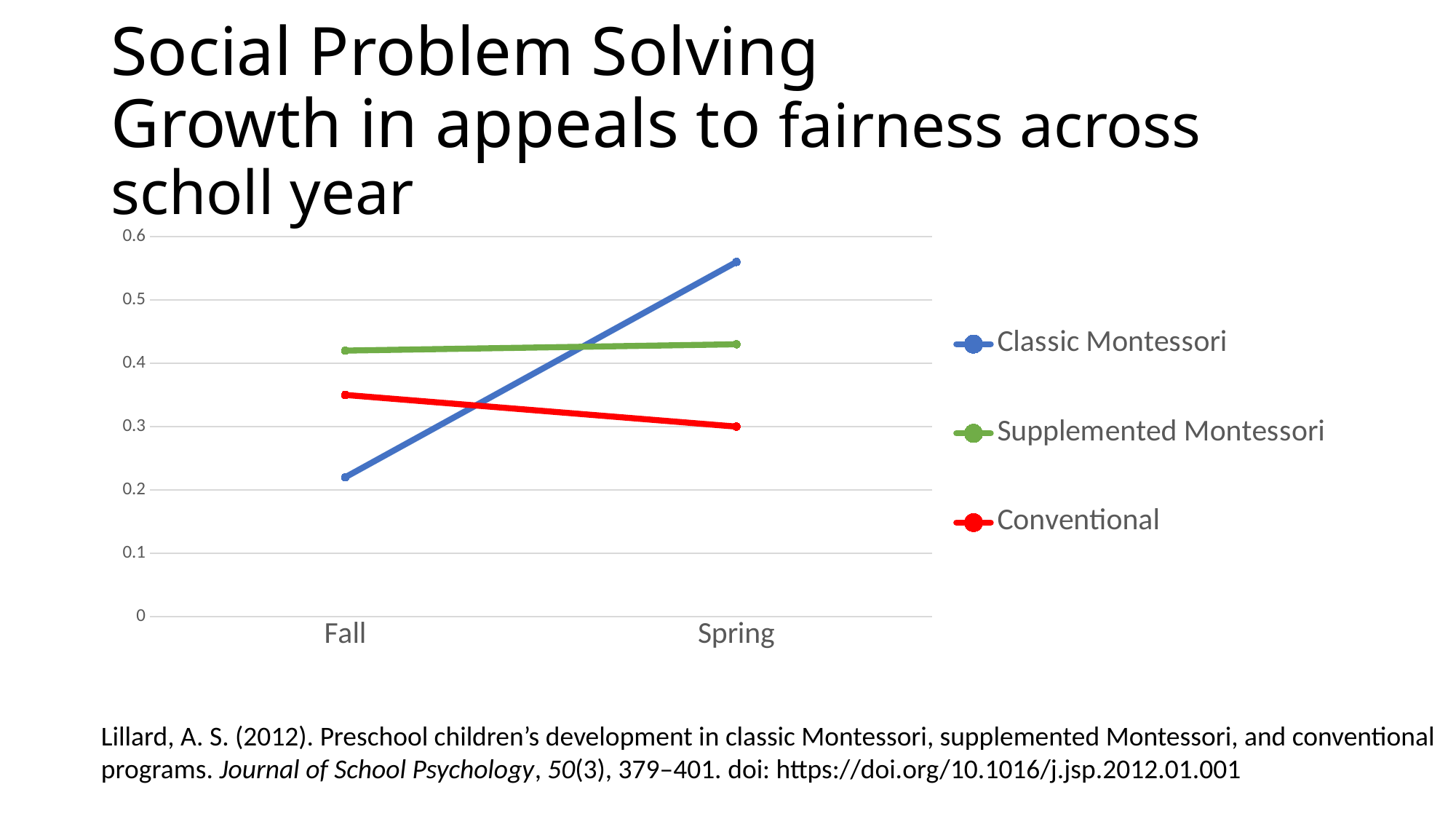
What kind of chart is shown on the slide? line chart Is the value for Classic Montessori in Spring greater or less than 0.5? greater Which series has the lowest value in Fall? Classic Montessori Which series has the highest value in Spring? Classic Montessori Which series has the highest value in Fall? Supplemented Montessori In Spring, which is larger: Classic Montessori or Conventional? Classic Montessori Is the value for Classic Montessori in Fall greater or less than 0.3? less How many series does the legend list? 3 Does the Classic Montessori line rise or fall from Fall to Spring? rise How many time points are shown on the x axis? 2 Which colour is used for the Conventional series? red Does the Conventional line rise or fall from Fall to Spring? fall